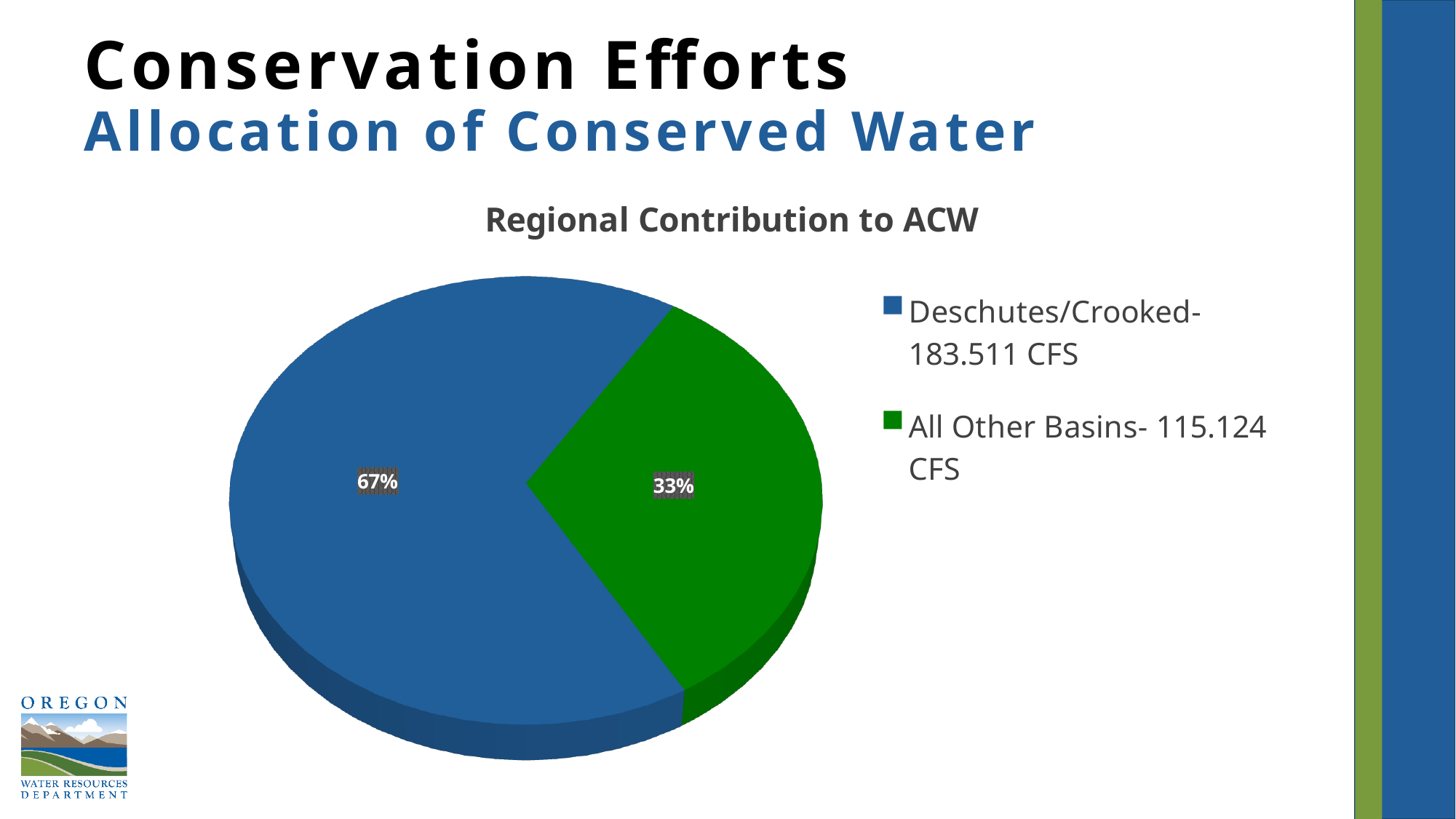
How many entries does the legend list? 2 What is the difference in percentage points between the Deschutes/Crooked share and the All Other Basins share? 34% Which has a larger share, Deschutes/Crooked or All Other Basins? Deschutes/Crooked How many slices does the pie chart have? 2 What percentage share of the pie does Deschutes/Crooked represent? 67% What type of chart is shown on the slide? Pie chart What percentage share of the pie does All Other Basins represent? 33% Which slice is the smallest in the pie chart? All Other Basins What is the CFS value shown in the legend for Deschutes/Crooked? 183.511 CFS What is the CFS value shown in the legend for All Other Basins? 115.124 CFS What is the title of the chart? Regional Contribution to ACW Which slice is the largest in the pie chart? Deschutes/Crooked